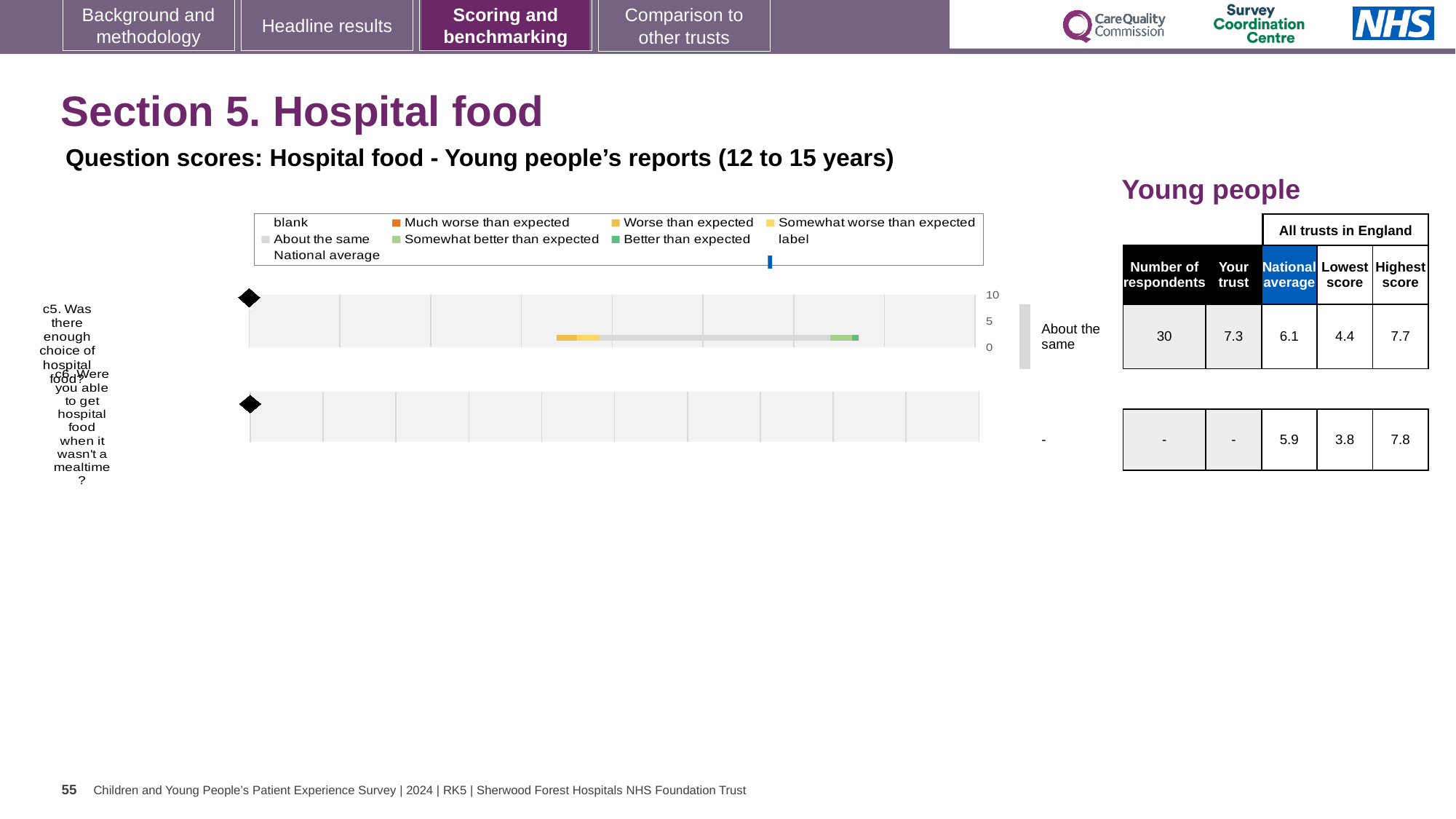
What is the 'Your trust' score for question c5 (Was there enough choice of hospital food?)? 7.3 What is the difference between the 'Your trust' score and the national average for question c5? 1.2 Which is larger for question c5: the 'Your trust' score or the national average? Your trust What is the difference between the highest and lowest scores across all trusts in England for question c6? 4.0 What is the national average score for question c5 (Was there enough choice of hospital food?)? 6.1 What is the highest score across all trusts in England for question c6 (Were you able to get hospital food when it wasn't a mealtime?)? 7.8 What colour does the legend use for 'Much worse than expected'? Orange What is the lowest score across all trusts in England for question c5 (Was there enough choice of hospital food?)? 4.4 What is the maximum value shown on the chart's score axis? 10 What benchmark category is shown for question c5 (Was there enough choice of hospital food?)? About the same How many respondents answered question c5 (Was there enough choice of hospital food?)? 30 How many question rows are plotted on the chart? 2